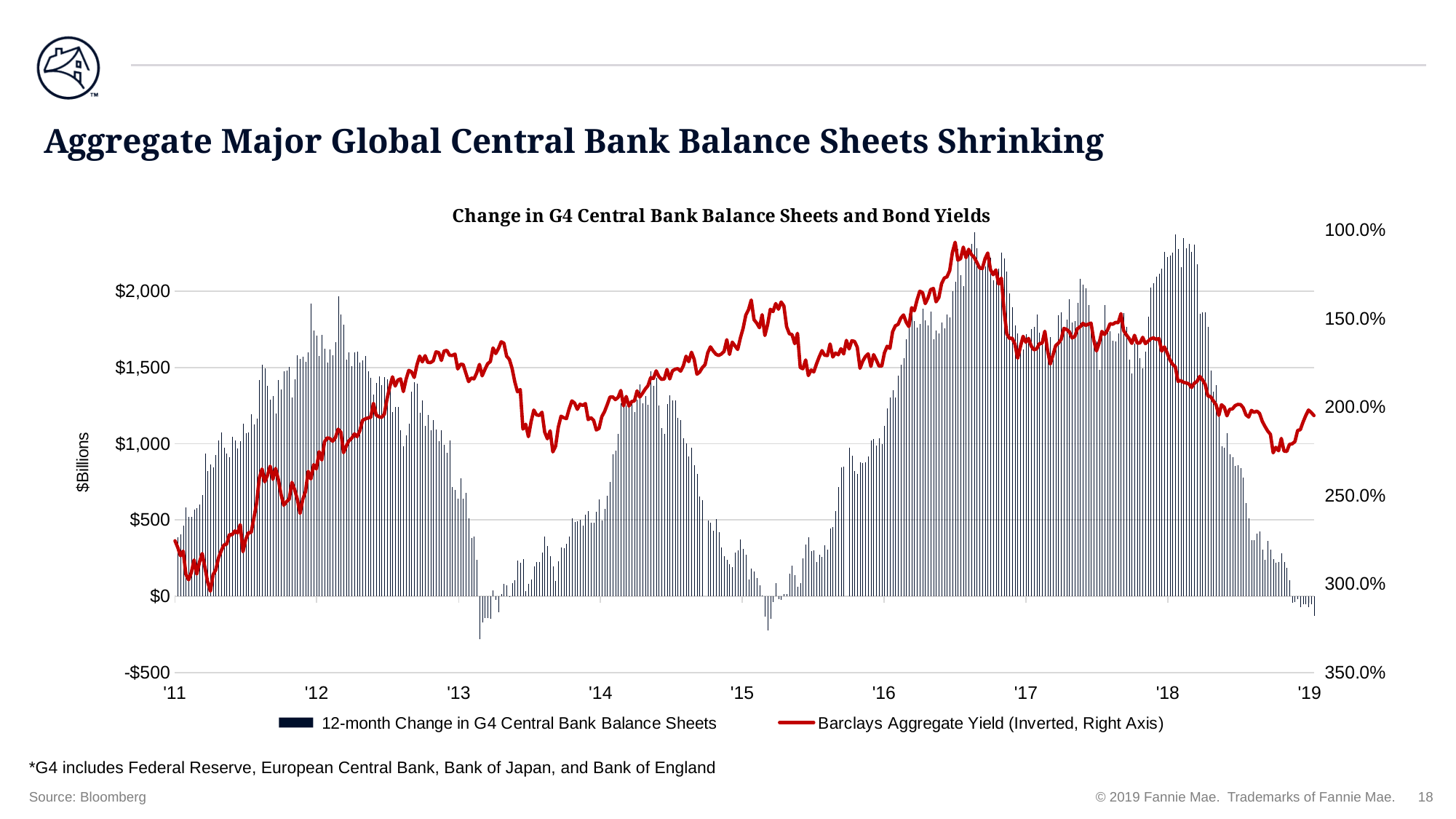
How many year labels are shown on the x axis of the chart? 9 Is the 12-month change in G4 central bank balance sheets at the '12 label greater or less than $1,000? greater How many series does the chart legend list? 2 Which series is plotted as a red line? Barclays Aggregate Yield (Inverted, Right Axis) Do the bars for the 12-month change in G4 central bank balance sheets rise or fall between the '18 and '19 labels? fall Is the 12-month change in G4 central bank balance sheets at the '17 label greater or less than $1,500? greater What unit is shown on the left vertical axis of the chart? $Billions Is the 12-month change in G4 central bank balance sheets at the '19 label greater or less than $0? less What kind of chart is shown on the slide? Combination bar and line chart What is the title of the chart? Change in G4 Central Bank Balance Sheets and Bond Yields